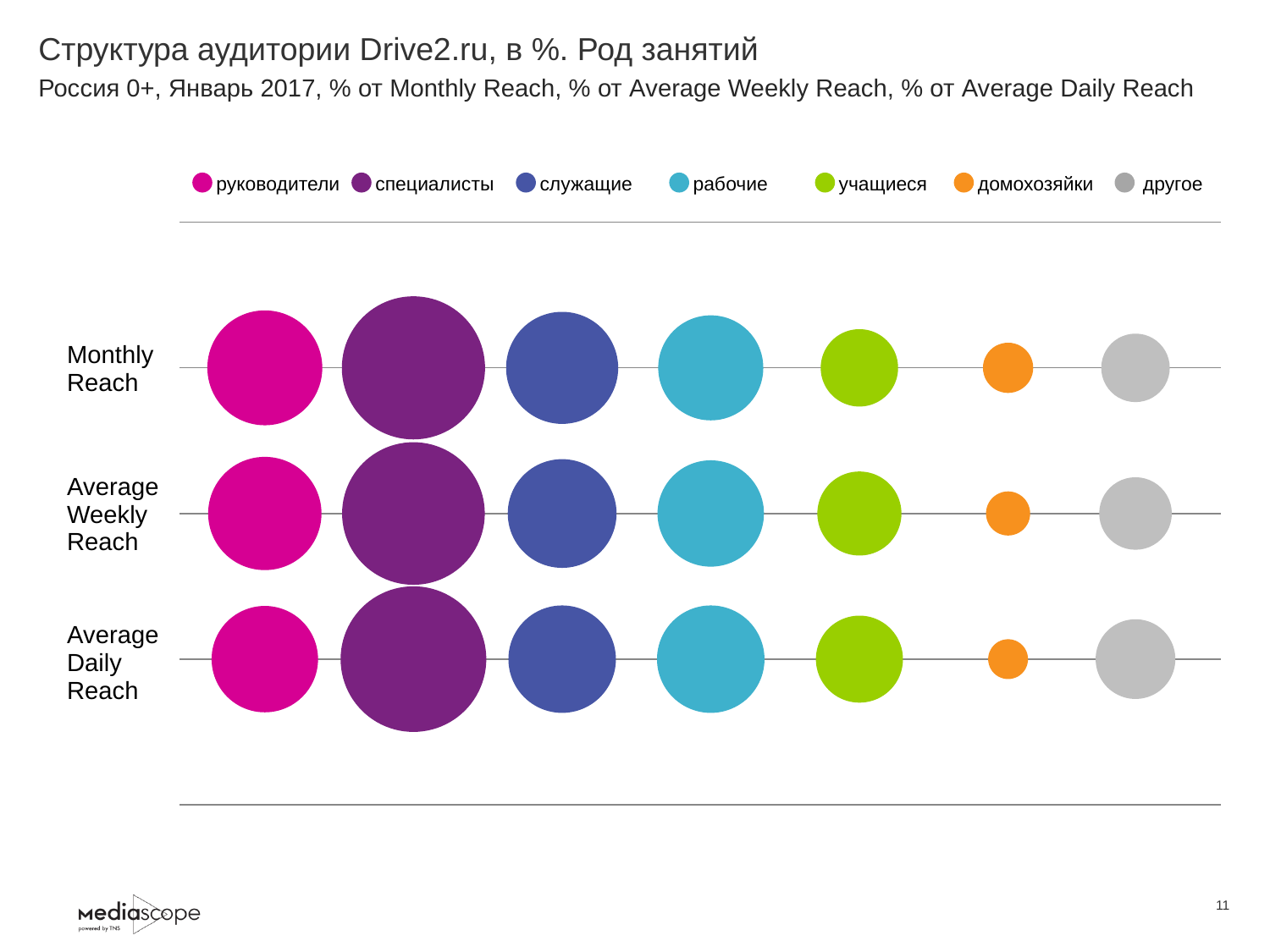
Which occupation group has the largest bubble in the Average Daily Reach row? специалисты Which occupation group has the smallest bubble in the Average Weekly Reach row? домохозяйки How many reach categories (rows) are plotted on the chart? 3 Which colour represents the series 'рабочие' in the legend? light blue In the Average Weekly Reach row, which bubble is larger: специалисты or служащие? специалисты In the Average Daily Reach row, which bubble is larger: другое or домохозяйки? другое In the Monthly Reach row, which bubble is larger: руководители or учащиеся? руководители Which occupation group has the largest bubble in the Monthly Reach row? специалисты What is the title of the chart on the slide? Структура аудитории Drive2.ru, в %. Род занятий How many series does the legend list? 7 Which occupation group has the smallest bubble in the Monthly Reach row? домохозяйки What kind of chart is shown on the slide? bubble chart